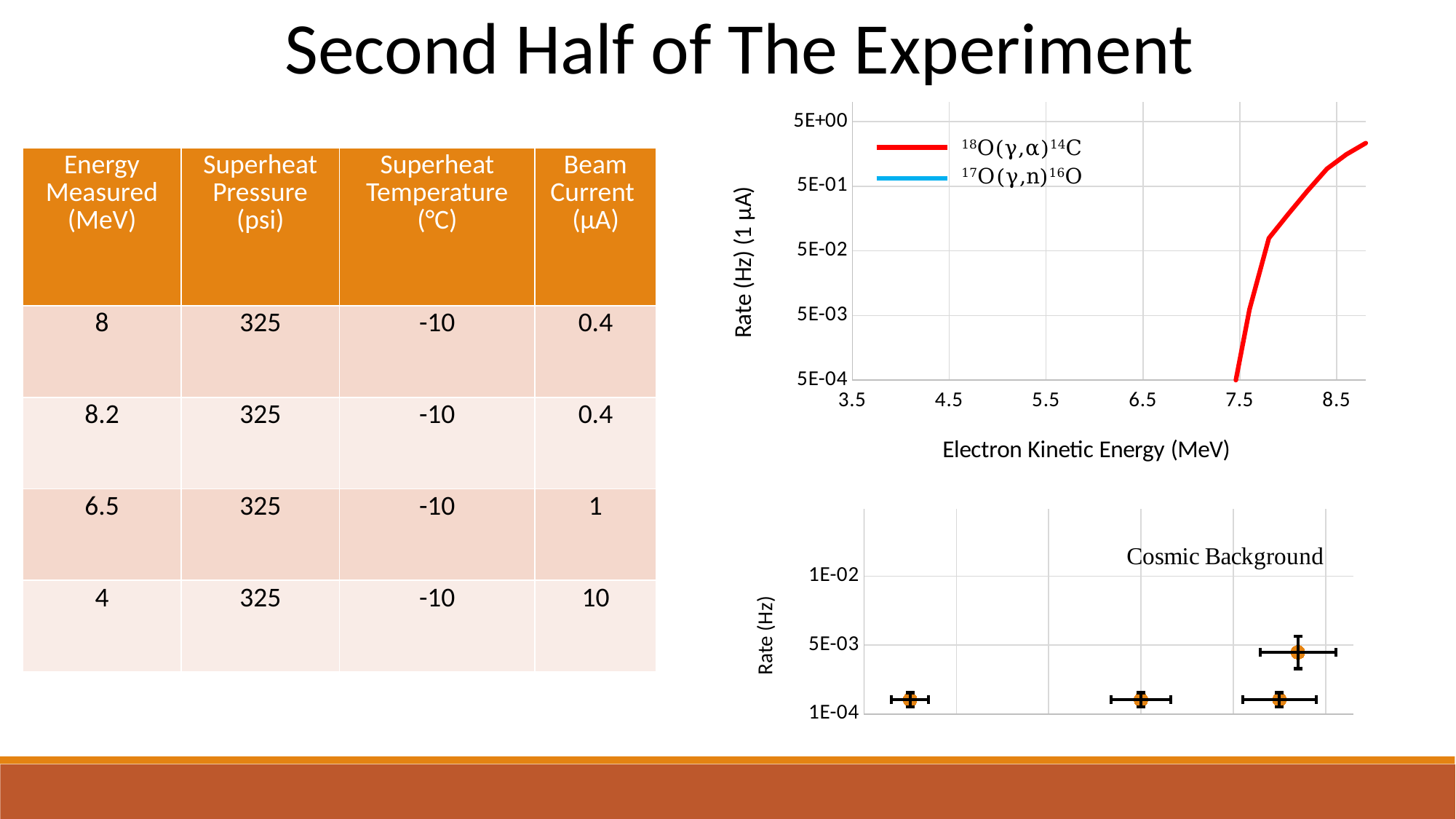
In the bottom Cosmic Background chart, how many data points lie at the 1E-04 level? 3 In the top chart, does the red 18O(γ,α)14C line rise or fall as Electron Kinetic Energy increases? rises What kind of chart is the top chart on the right of the slide? line chart In the bottom Cosmic Background chart, is the highest data point greater or less than 1E-04? greater In the top chart, what is the lowest value shown on the x axis? 3.5 In the top chart, is the rate for the 18O(γ,α)14C series at 8 MeV greater or less than 5E-03? greater In the top chart, what colour is the 18O(γ,α)14C line? red What kind of chart is the bottom chart on the right of the slide? scatter chart How many data points are plotted in the bottom Cosmic Background chart? 4 How many series does the legend of the top chart list? 2 In the top chart, is the rate for the 18O(γ,α)14C series at 8.5 MeV greater or less than 5E-02? greater